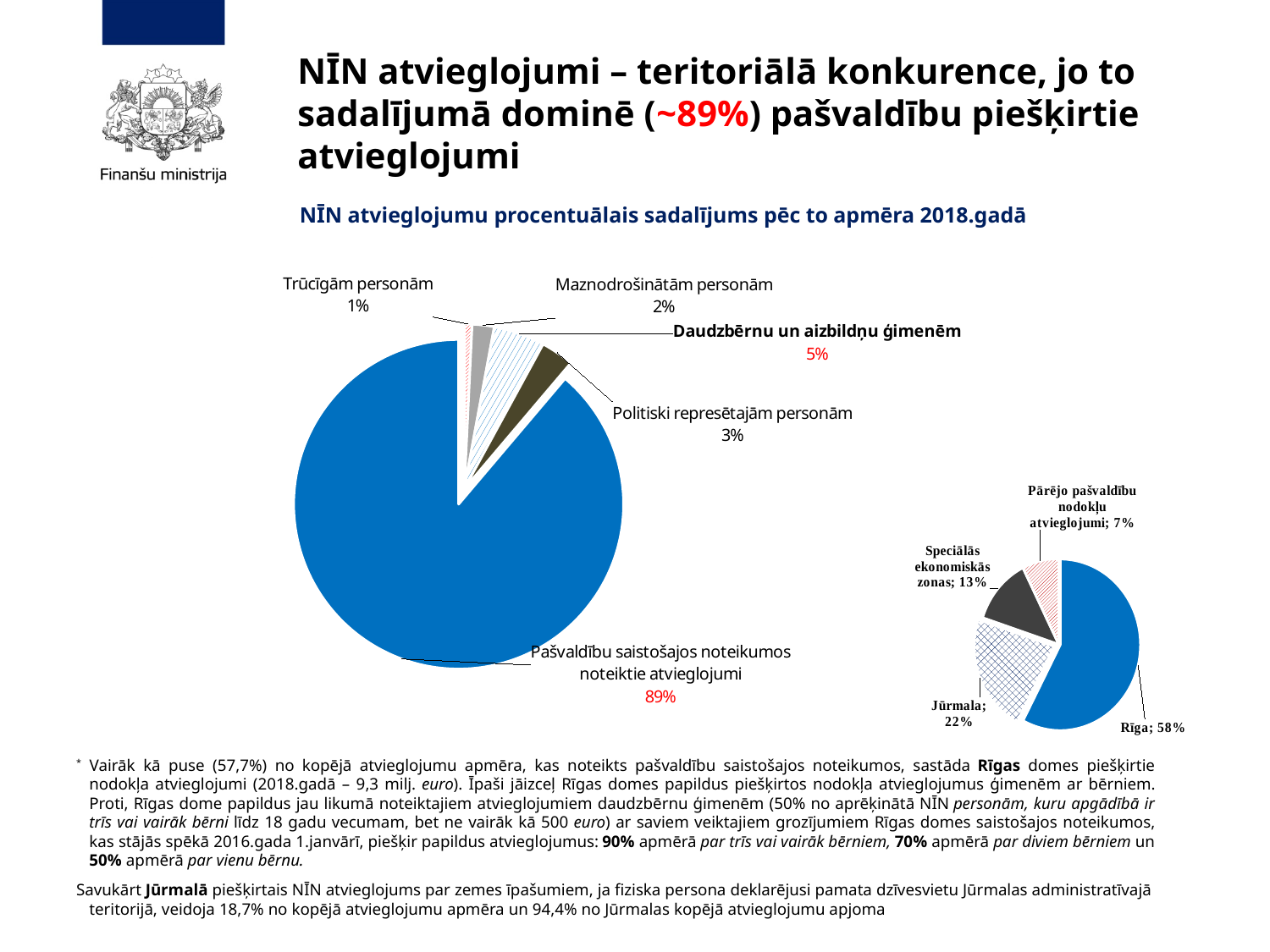
On the small pie chart at the bottom right, which is larger: "Speciālās ekonomiskās zonas" or "Pārējo pašvaldību nodokļu atvieglojumi"? Speciālās ekonomiskās zonas On the large pie chart, what share is shown for "Daudzbērnu un aizbildņu ģimenēm"? 5% On the large pie chart, what share is shown for "Politiski represētajām personām"? 3% On the large pie chart, which category has the smallest share? Trūcīgām personām On the large pie chart, which category has the largest share? Pašvaldību saistošajos noteikumos noteiktie atvieglojumi What type of chart is the large chart on the slide? Pie chart On the large pie chart, how many slices (categories) are shown? 5 On the large pie chart, what is the difference in percentage points between "Daudzbērnu un aizbildņu ģimenēm" and "Maznodrošinātām personām"? 3 percentage points On the small pie chart at the bottom right, how many slices are shown? 4 On the small pie chart at the bottom right, what share is shown for Jūrmala? 22% On the small pie chart at the bottom right, what share is shown for Rīga? 58% On the large pie chart titled "NĪN atvieglojumu procentuālais sadalījums pēc to apmēra 2018.gadā", what share is shown for "Pašvaldību saistošajos noteikumos noteiktie atvieglojumi"? 89%